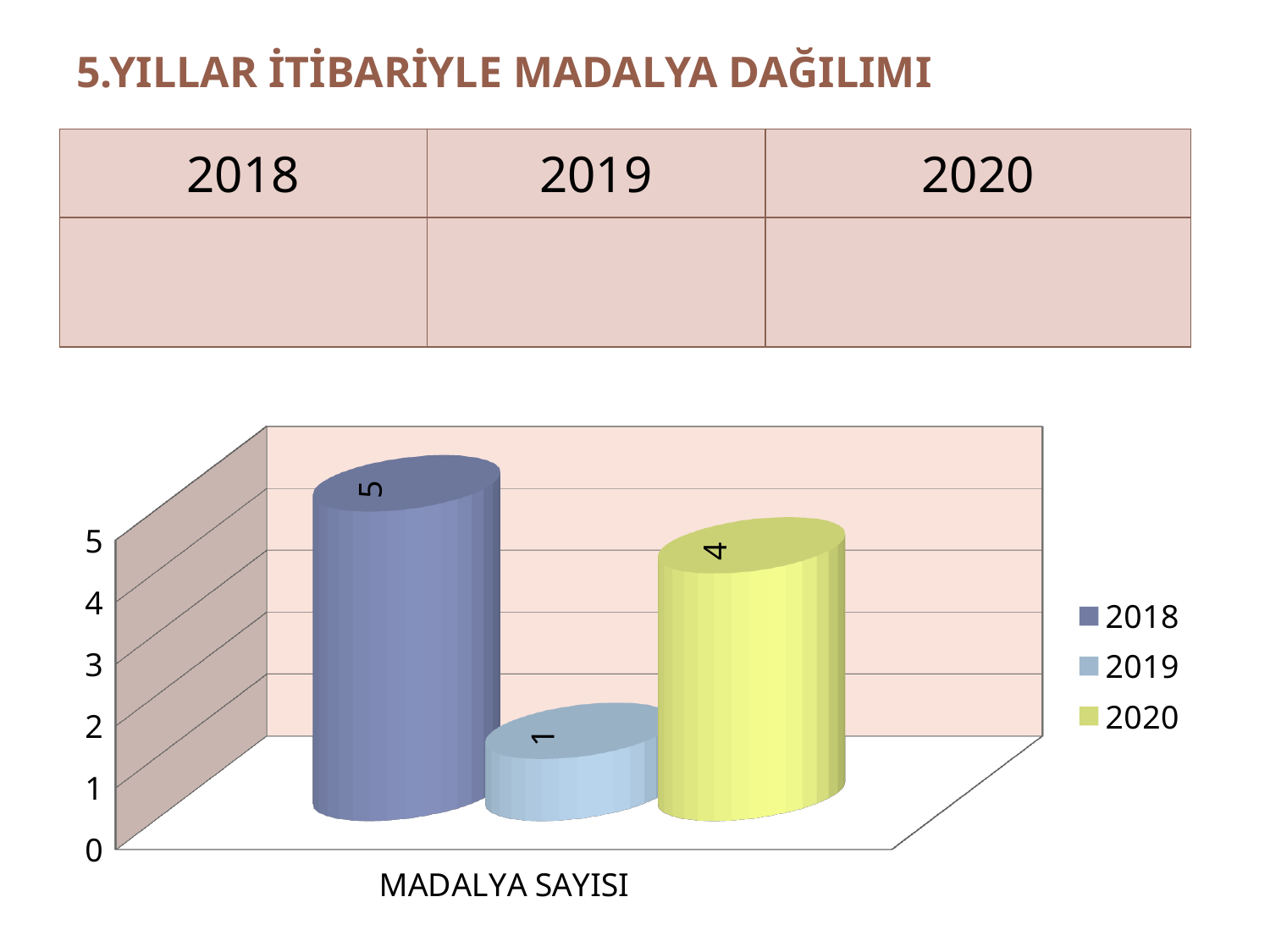
Which colour represents 2020 in the chart's legend? yellow How many series does the legend list? 3 Which is larger, the value for 2020 or the value for 2019? 2020 Which year has the lowest value in the chart? 2019 What is the category label shown on the x axis of the chart? MADALYA SAYISI Which year has the highest value in the chart? 2018 What kind of chart is shown on the slide? bar chart What is the difference between the values for 2018 and 2020? 1 What is the difference between the values for 2018 and 2019? 4 What is the value for 2018 in the chart? 5 What is the value for 2020 in the chart? 4 What is the value for 2019 in the chart? 1